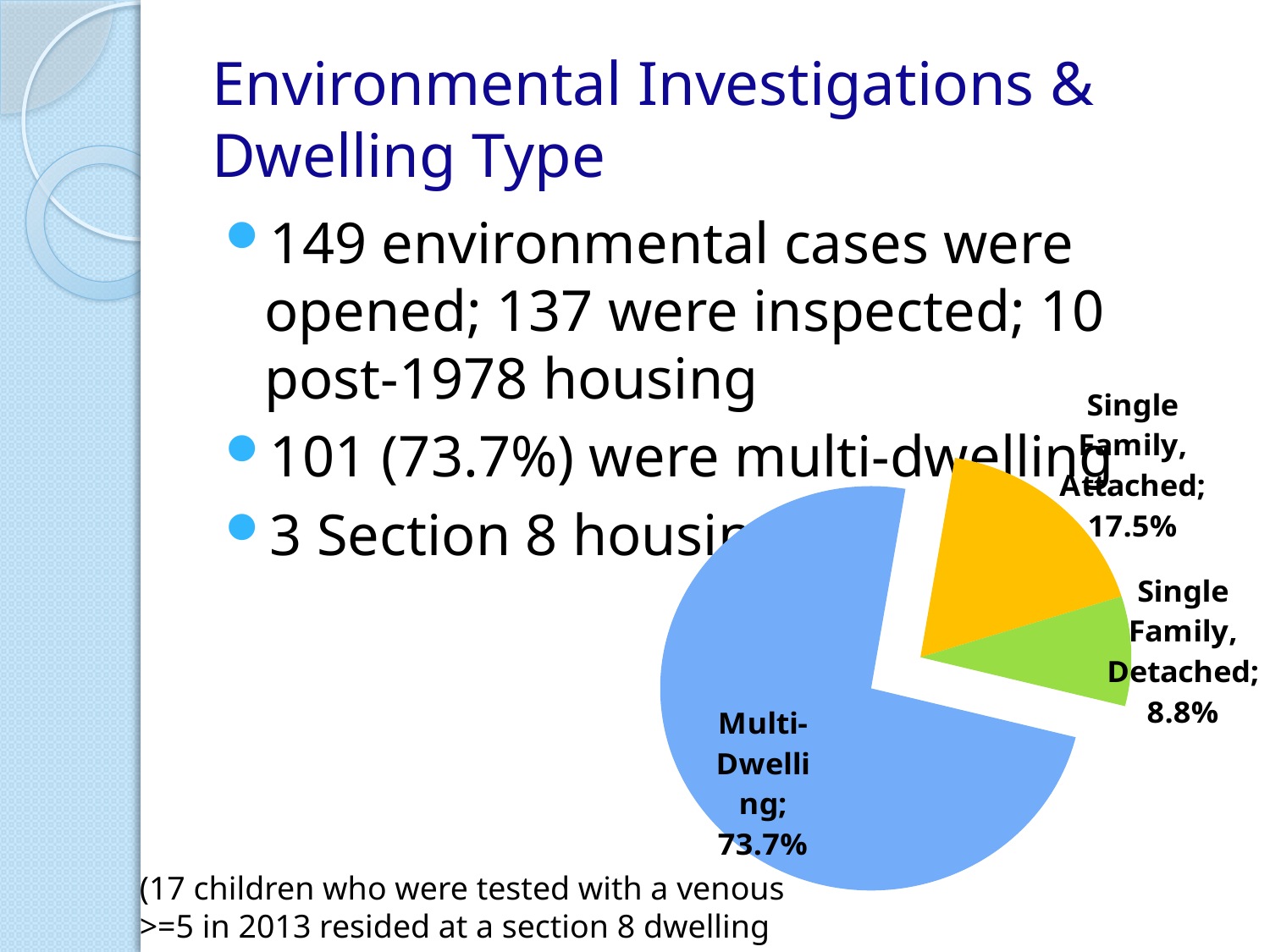
What kind of chart is shown on the slide? pie chart What is the difference between the Multi-Dwelling share and the Single Family, Attached share? 56.2% What is the value shown for Single Family, Attached? 17.5% Which is larger, the Single Family, Attached slice or the Single Family, Detached slice? Single Family, Attached What is the value shown for Single Family, Detached? 8.8% Which dwelling type has the smallest slice of the pie? Single Family, Detached What colour is the Single Family, Detached slice? green Which dwelling type has the largest slice of the pie? Multi-Dwelling How many slices does the pie chart have? 3 What share of the pie does Multi-Dwelling represent? 73.7% What colour is the Multi-Dwelling slice? blue What is the difference between the Single Family, Attached share and the Single Family, Detached share? 8.7%